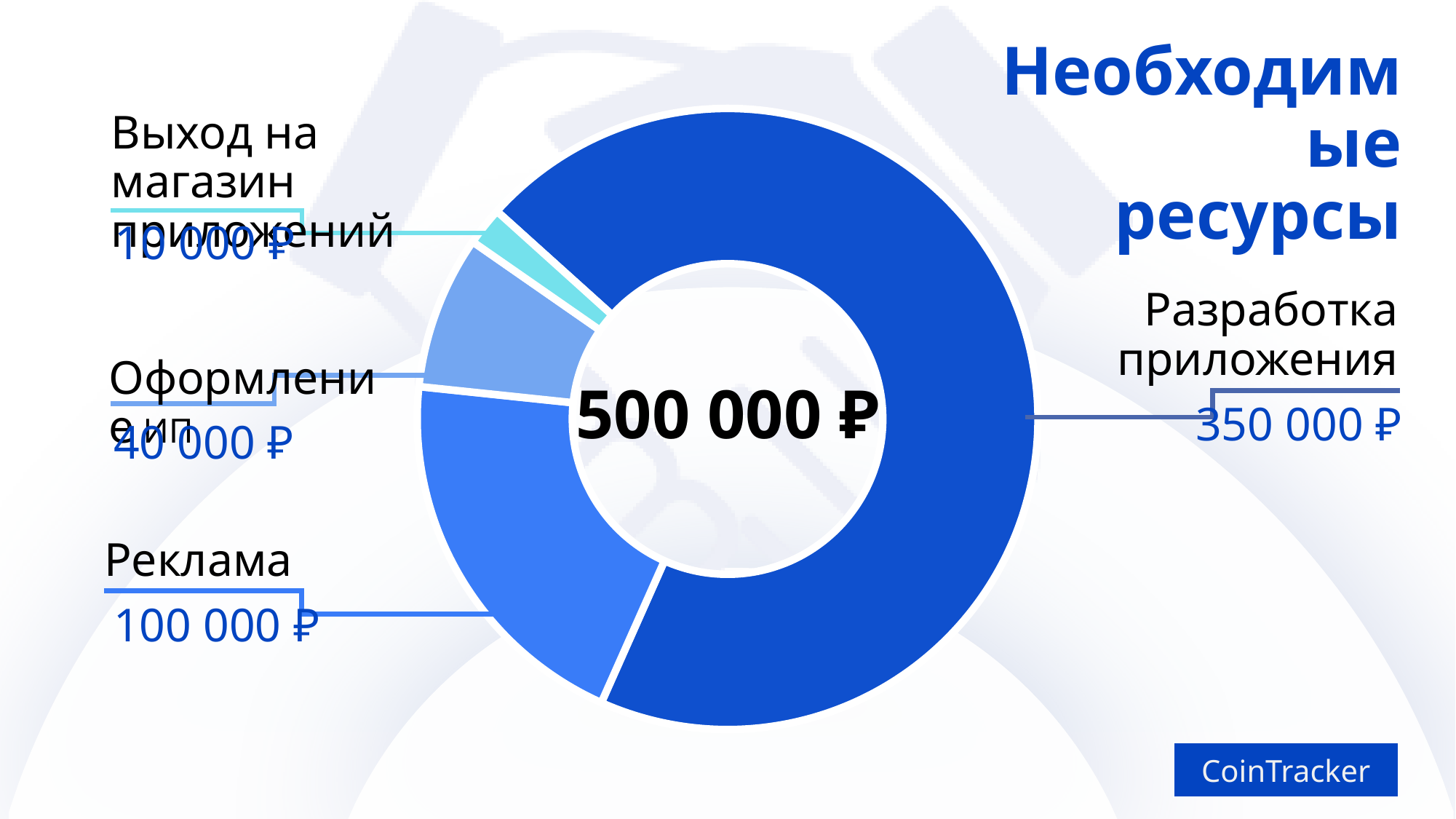
What total is shown in the centre of the chart? 500 000 ₽ Which is larger, Реклама or Оформление ИП? Реклама What type of chart is shown on the slide? Donut (pie) chart What is the difference between Разработка приложения and Реклама? 250 000 ₽ Which category has the smallest value? Выход на магазин приложений What share of the total does Разработка приложения represent? 70% Which category has the largest value? Разработка приложения What is the value for Разработка приложения? 350 000 ₽ How many categories does the chart show? 4 What is the value for Выход на магазин приложений? 10 000 ₽ What is the value for Реклама? 100 000 ₽ What is the value for Оформление ИП? 40 000 ₽